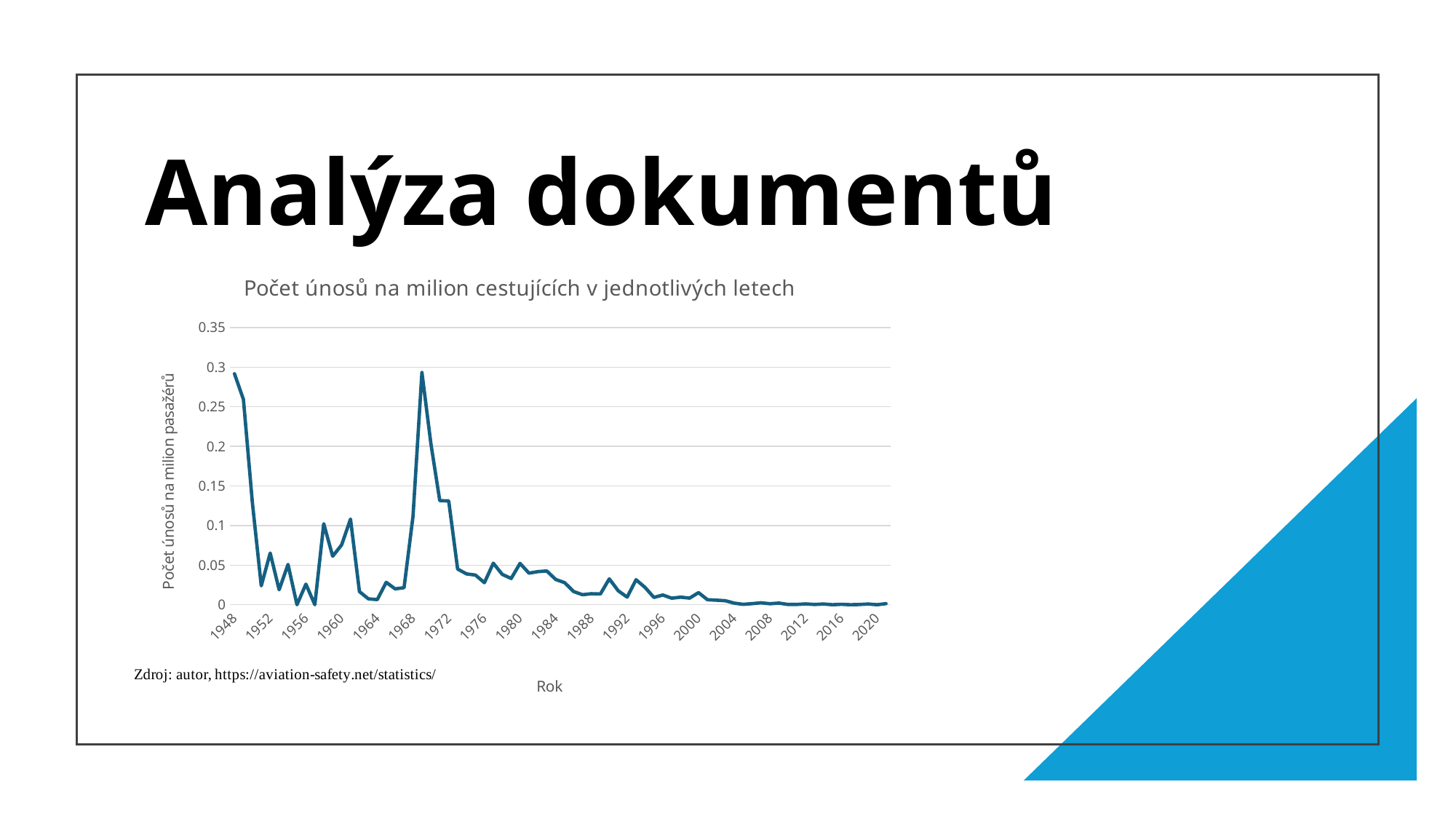
What is the title of the chart? Počet únosů na milion cestujících v jednotlivých letech Is the value for 2000 greater or less than 0.05? less Which year has the larger value, 1972 or 1976? 1972 What kind of chart is shown on the slide? line chart Which year has the larger value, 1948 or 2020? 1948 Is the value for 1972 greater or less than 0.1? greater Is the value for 2020 greater or less than 0.05? less Overall, do the values rise or fall from 1948 to 2020? fall What is the label of the x axis of the chart? Rok How many lines (data series) are plotted on the chart? 1